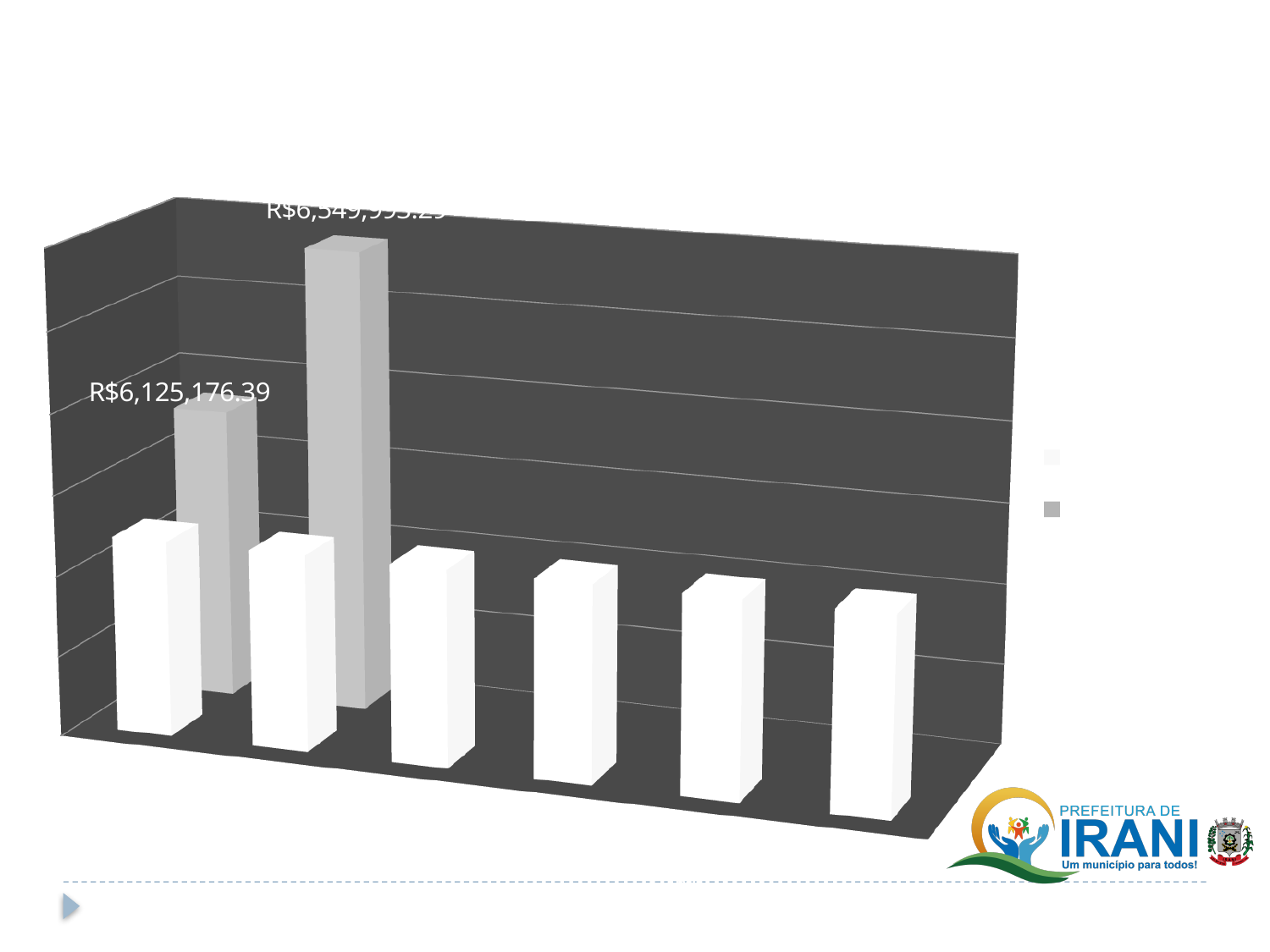
How many white bars are plotted in the front row of the chart? 6 What value is printed above the leftmost grey bar? R$6,125,176.39 Is the leftmost grey bar taller or shorter than the leftmost white bar? taller What kind of chart is shown on the slide? bar chart Which of the two grey bars is taller, the left one or the right one? the right one How many grey bars are plotted in the back row of the chart? 2 How many series does the legend list? 2